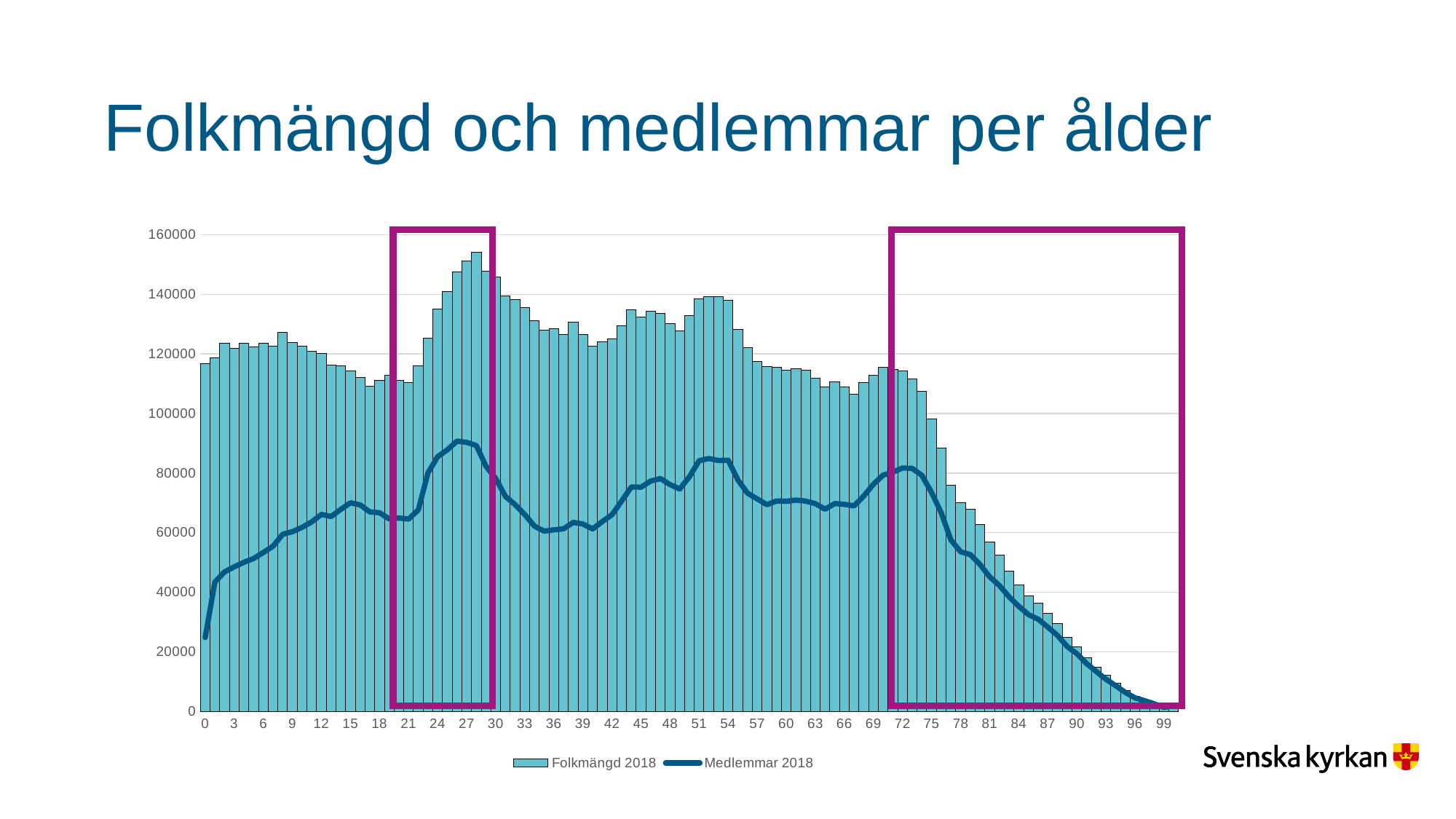
What is the title of the chart slide? Folkmängd och medlemmar per ålder Is the Medlemmar 2018 value at age 0 greater or less than 40000? less What kind of chart is shown on the slide? A combined bar and line chart Do the Folkmängd 2018 values rise or fall from age 75 to age 99? Fall What are the two series named in the legend? Folkmängd 2018 and Medlemmar 2018 Is the Medlemmar 2018 value at age 36 greater or less than 80000? less Is the Medlemmar 2018 value at age 27 greater or less than 80000? greater Which is larger, the Folkmängd 2018 value at age 27 or at age 36? Age 27 How many series does the legend list? 2